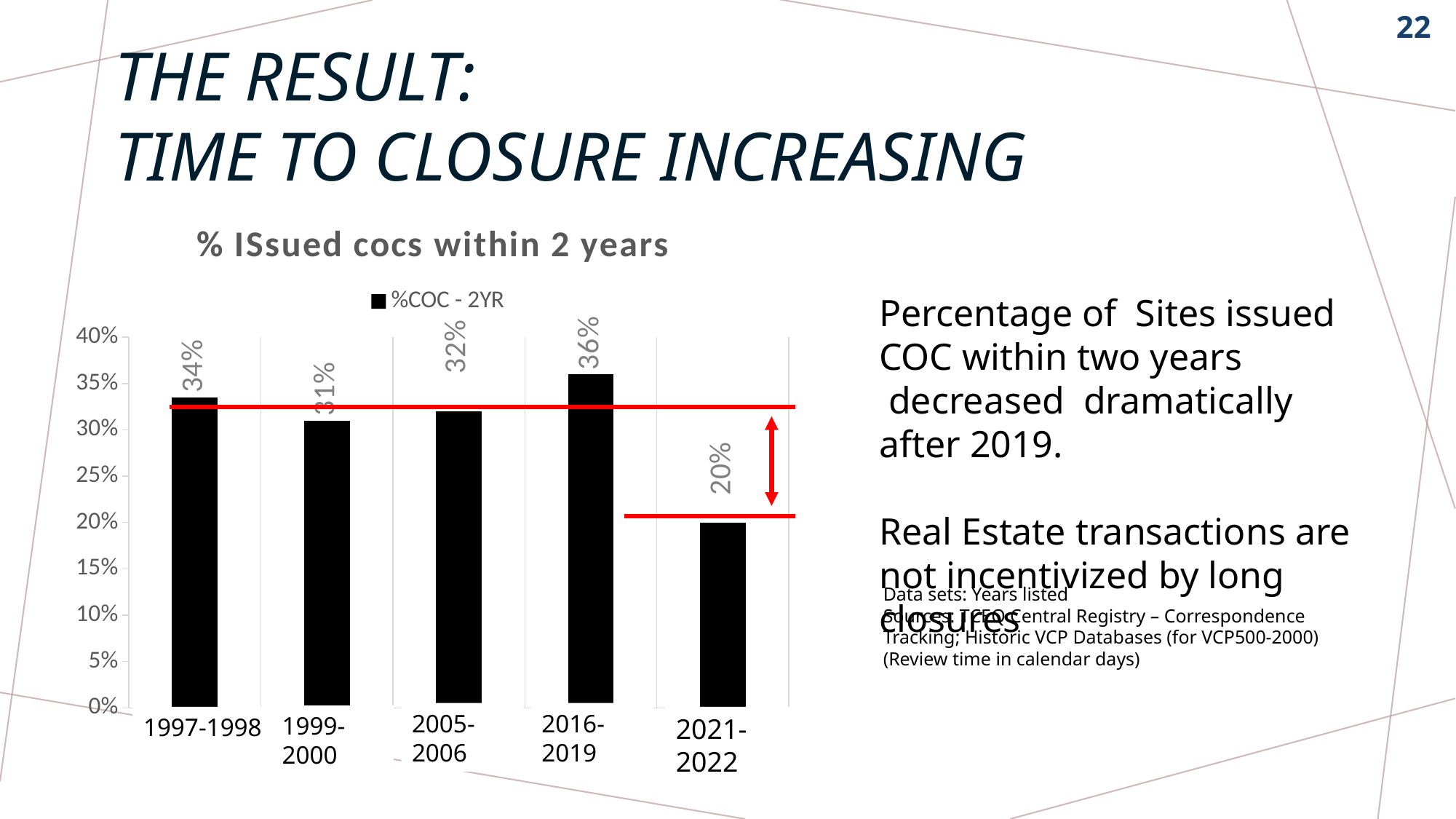
What is the difference between the values for 2016-2019 and 2021-2022? 16% What is the value for 2016-2019? 36% How many periods are shown on the x axis? 5 What is the value for 1997-1998? 34% Which period has the lowest percentage of COCs issued within 2 years? 2021-2022 How many series does the legend list? 1 What is the value for 2021-2022? 20% Which period has the highest percentage of COCs issued within 2 years? 2016-2019 What is the legend entry for the series? %COC - 2YR Is the value for 2021-2022 greater or less than 25%? less Which is larger, the value for 1999-2000 or the value for 2005-2006? 2005-2006 What kind of chart is shown? bar chart